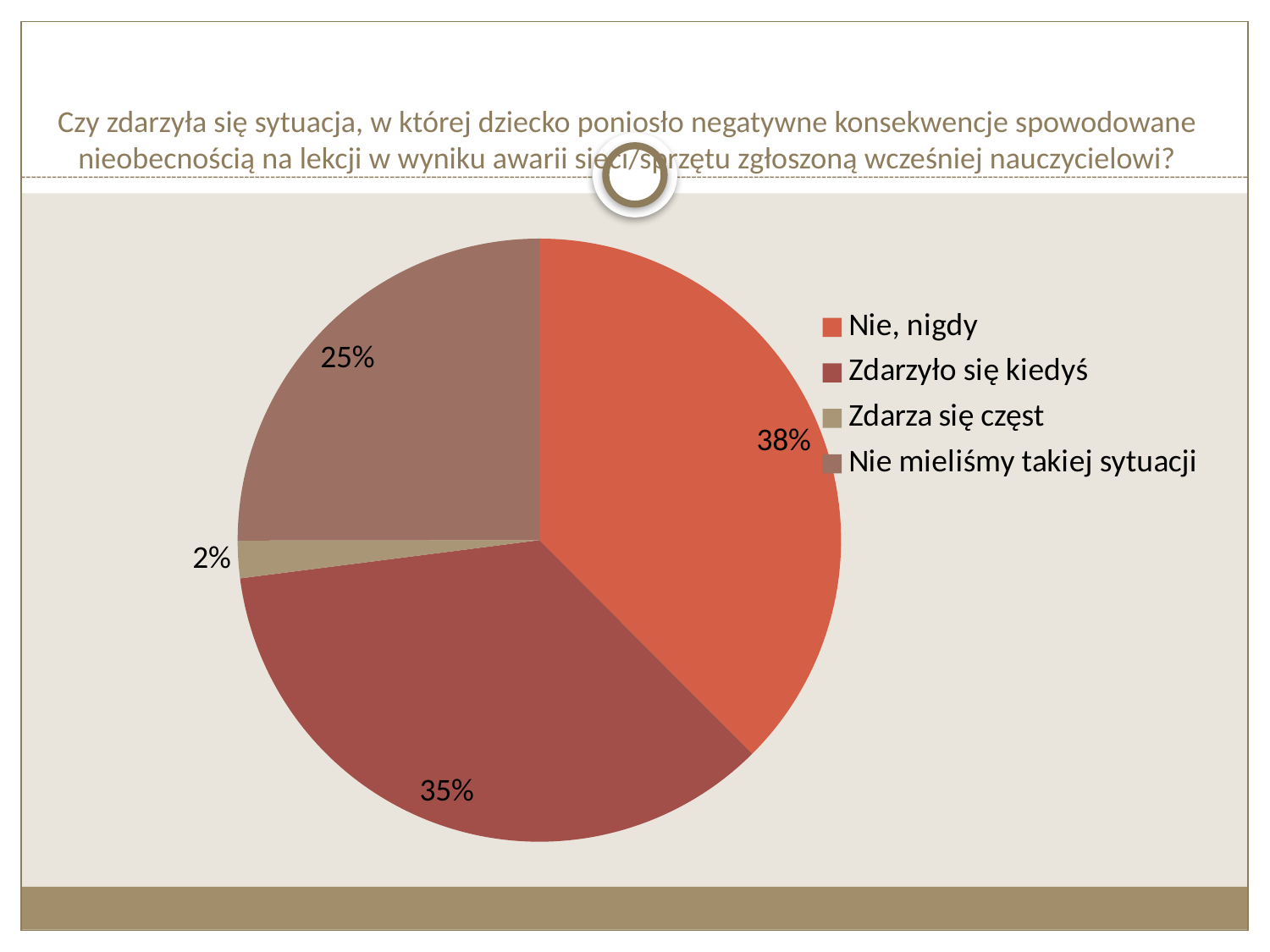
Which legend entry is shown in the lightest, tan colour? Zdarza się częst What kind of chart is shown on the slide? pie chart What percentage of the pie is labelled for "Zdarzyło się kiedyś"? 35% What percentage of the pie is labelled for "Nie, nigdy"? 38% What is the difference in percentage points between "Nie, nigdy" and "Nie mieliśmy takiej sytuacji"? 13 What percentage of the pie is labelled for "Zdarza się częst"? 2% What percentage of the pie is labelled for "Nie mieliśmy takiej sytuacji"? 25% How many categories does the legend list? 4 Which is larger: the slice for "Zdarzyło się kiedyś" or the slice for "Nie mieliśmy takiej sytuacji"? Zdarzyło się kiedyś What is the difference in percentage points between "Nie mieliśmy takiej sytuacji" and "Zdarza się częst"? 23 Which category has the smallest slice of the pie? Zdarza się częst Which category has the largest slice of the pie? Nie, nigdy